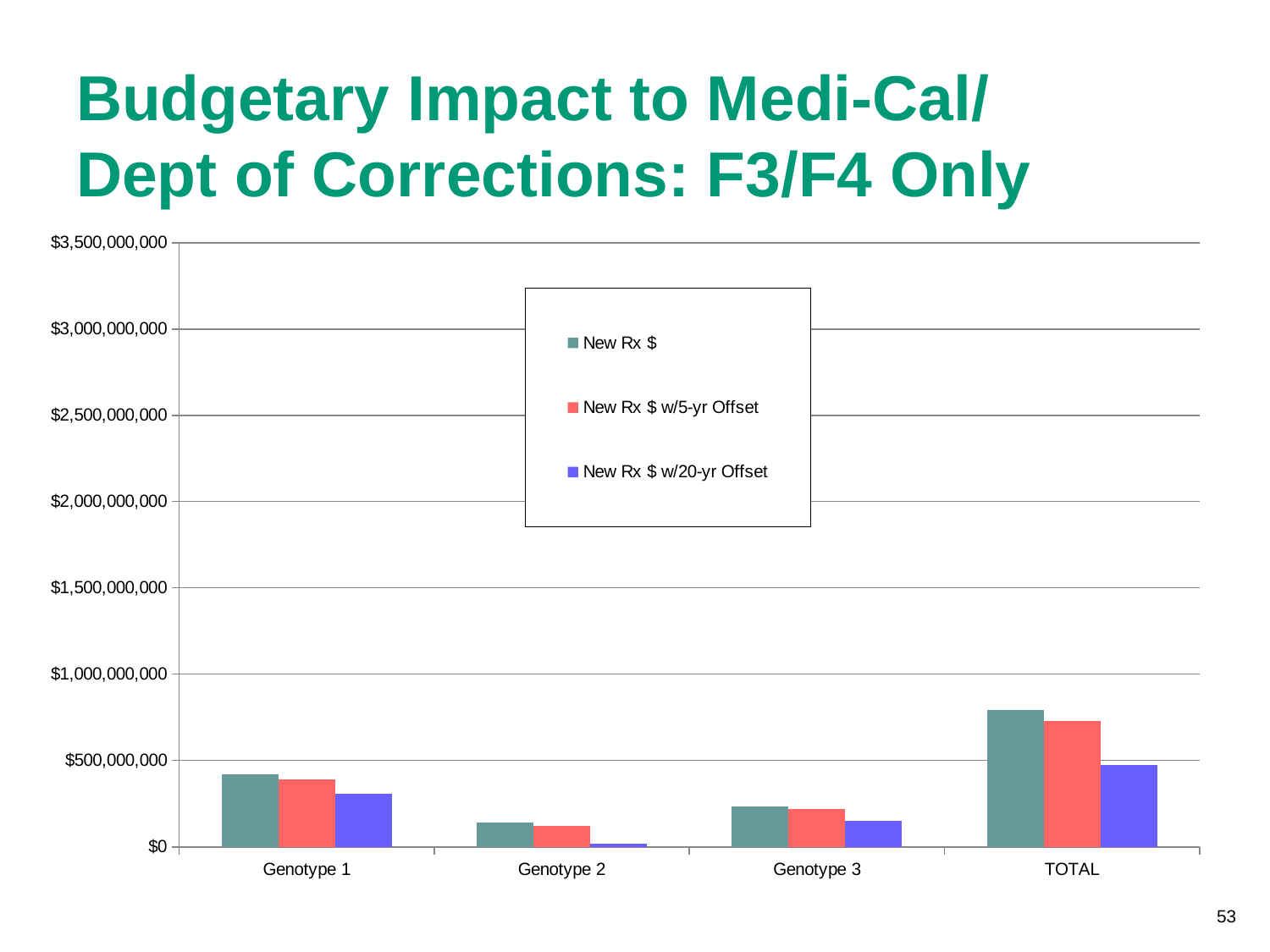
Which category has the highest value for New Rx $? TOTAL What is the name of the series shown in red? New Rx $ w/5-yr Offset Which category has the lowest value for New Rx $ w/20-yr Offset? Genotype 2 Which is larger for New Rx $ w/5-yr Offset: Genotype 2 or Genotype 3? Genotype 3 Within the TOTAL category, do the values rise or fall going from New Rx $ to New Rx $ w/20-yr Offset? fall Is the value for TOTAL in the New Rx $ series greater or less than $1,000,000,000? less Is the value for TOTAL in the New Rx $ series greater or less than $500,000,000? greater Which is larger for New Rx $: Genotype 1 or Genotype 3? Genotype 1 What kind of chart is shown on the slide? bar chart How many series does the legend list? 3 Is the value for Genotype 1 in the New Rx $ series greater or less than $500,000,000? less How many categories are shown on the x axis? 4